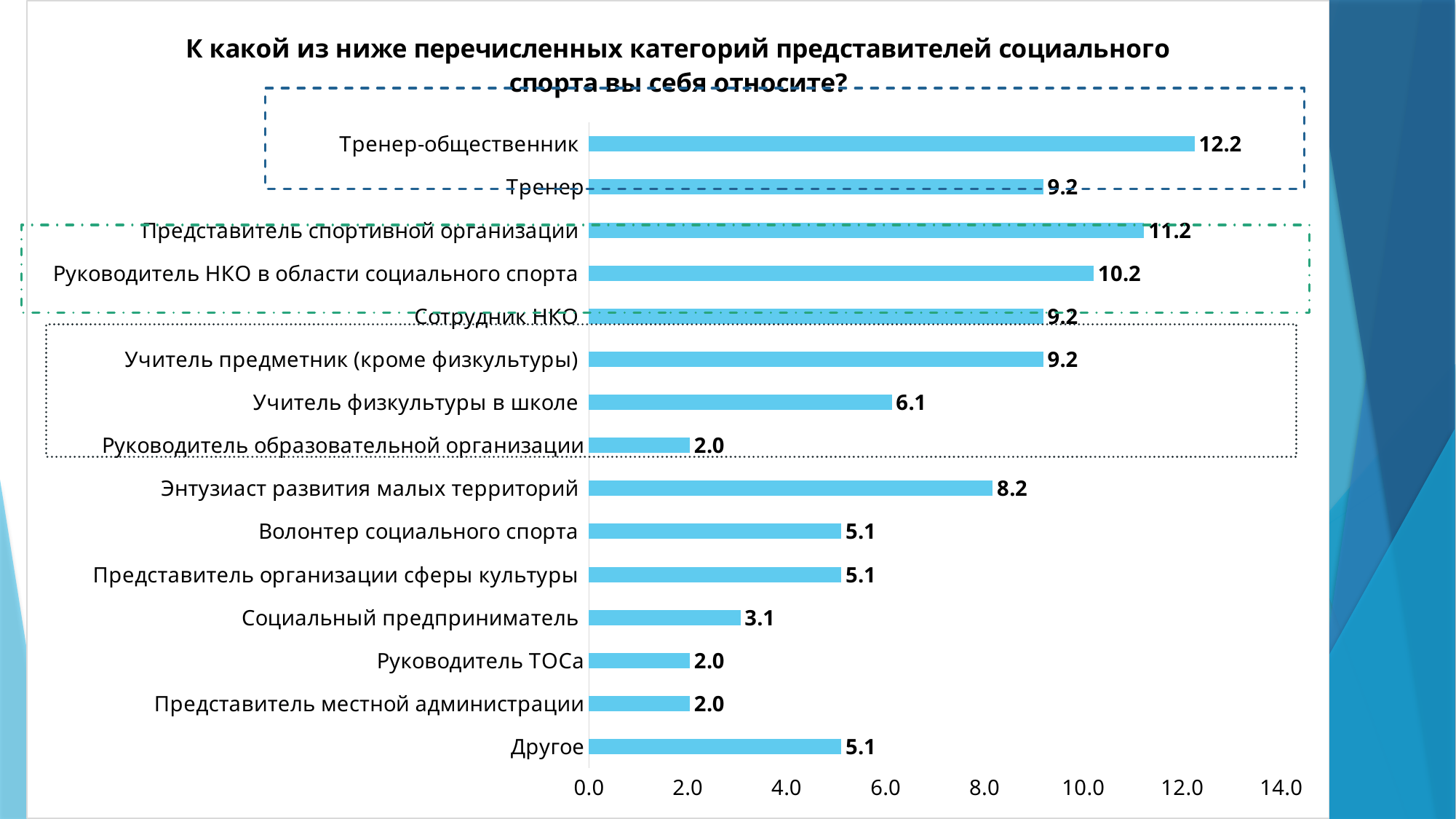
What is the value for Социальный предприниматель? 3.1 Which is larger, the value for Представитель спортивной организации or the value for Руководитель НКО в области социального спорта? Представитель спортивной организации What is the value for Руководитель НКО в области социального спорта? 10.2 What is the maximum value shown on the horizontal axis? 14.0 What is the value for Энтузиаст развития малых территорий? 8.2 How many categories are shown in the chart? 15 Which category has the highest value? Тренер-общественник What is the difference between the values for Тренер-общественник and Тренер? 3.0 What is the value for Учитель физкультуры в школе? 6.1 What is the difference between the values for Представитель спортивной организации and Волонтер социального спорта? 6.1 What type of chart is shown on the slide? bar chart What is the value for Тренер-общественник? 12.2